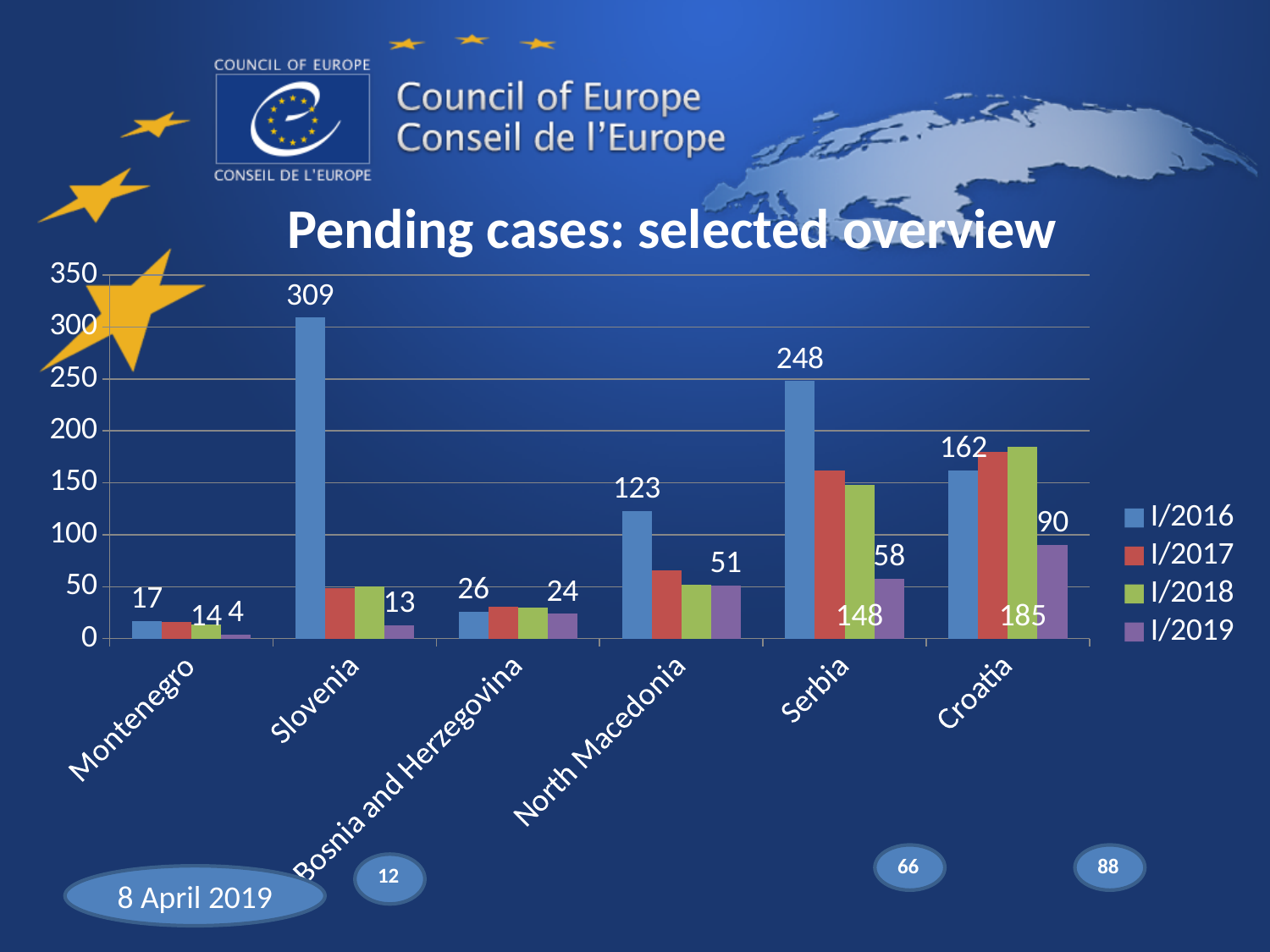
What is the difference between Serbia's I/2016 value and its I/2018 value? 100 Which country has the highest value in the I/2016 series? Slovenia What is the value for Serbia in the I/2018 series? 148 What is the difference between Croatia's I/2018 value and its I/2019 value? 95 What kind of chart is shown on the slide? bar chart How many countries are shown on the x axis? 6 What is the value for Croatia in the I/2019 series? 90 Is the value for North Macedonia in the I/2017 series greater or less than 100? less For Croatia, which is larger: the I/2016 value or the I/2018 value? I/2018 What is the value for Slovenia in the I/2016 series? 309 How many series does the legend list? 4 Which country has the lowest value in the I/2019 series? Montenegro